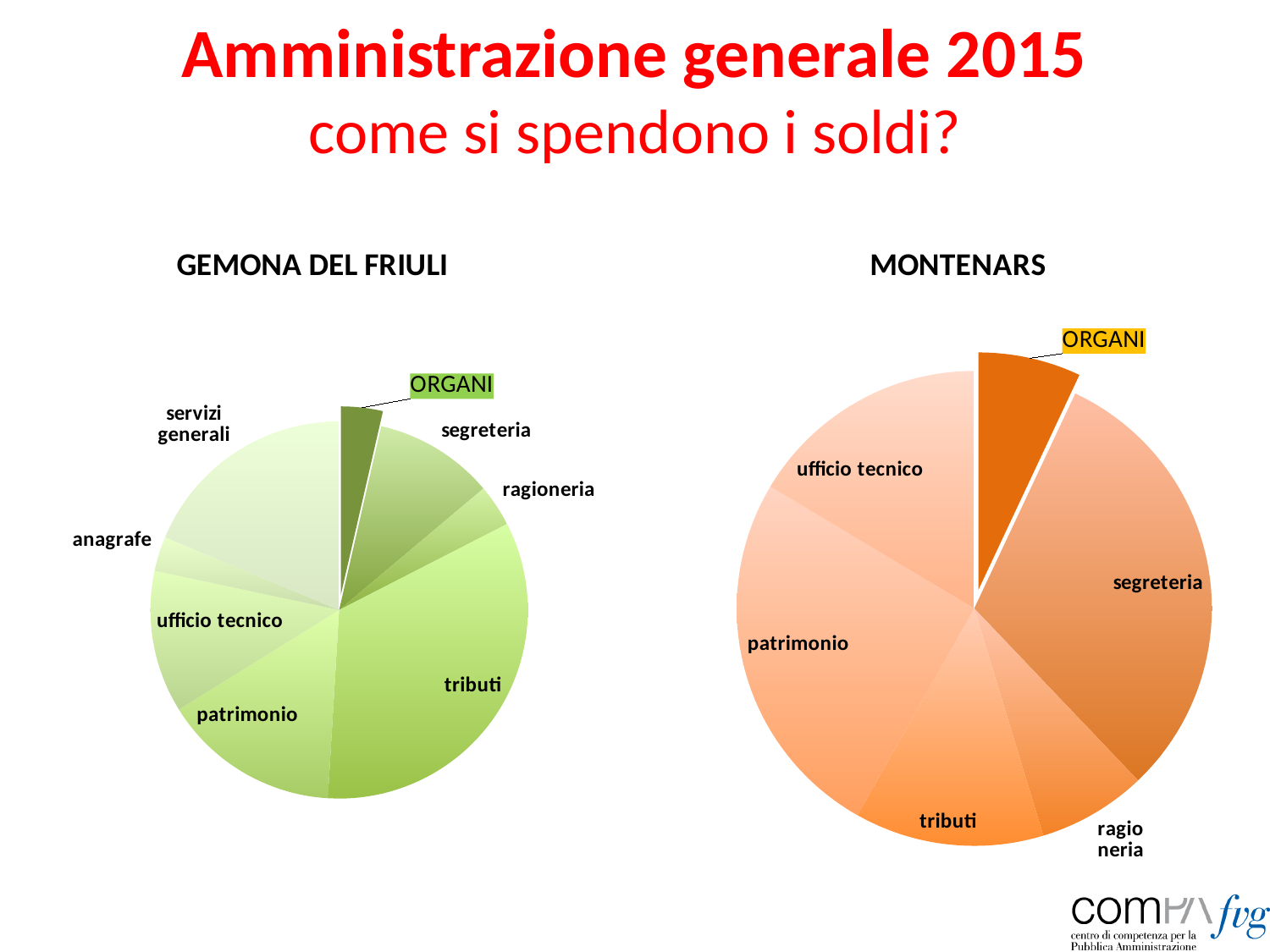
What kind of chart is used for GEMONA DEL FRIULI? pie chart In the MONTENARS chart, which category has the smallest slice? ORGANI In the MONTENARS chart, which slice is larger, tributi or ORGANI? tributi How many slices does the MONTENARS pie chart have? 6 Which slice is pulled out (exploded) from both pie charts? ORGANI What colour scheme is used for the MONTENARS pie chart? orange In the GEMONA DEL FRIULI chart, which slice is larger, servizi generali or ragioneria? servizi generali What kind of chart is used for MONTENARS? pie chart In the MONTENARS chart, which slice is larger, segreteria or ragioneria? segreteria In the GEMONA DEL FRIULI chart, which category has the largest slice? tributi